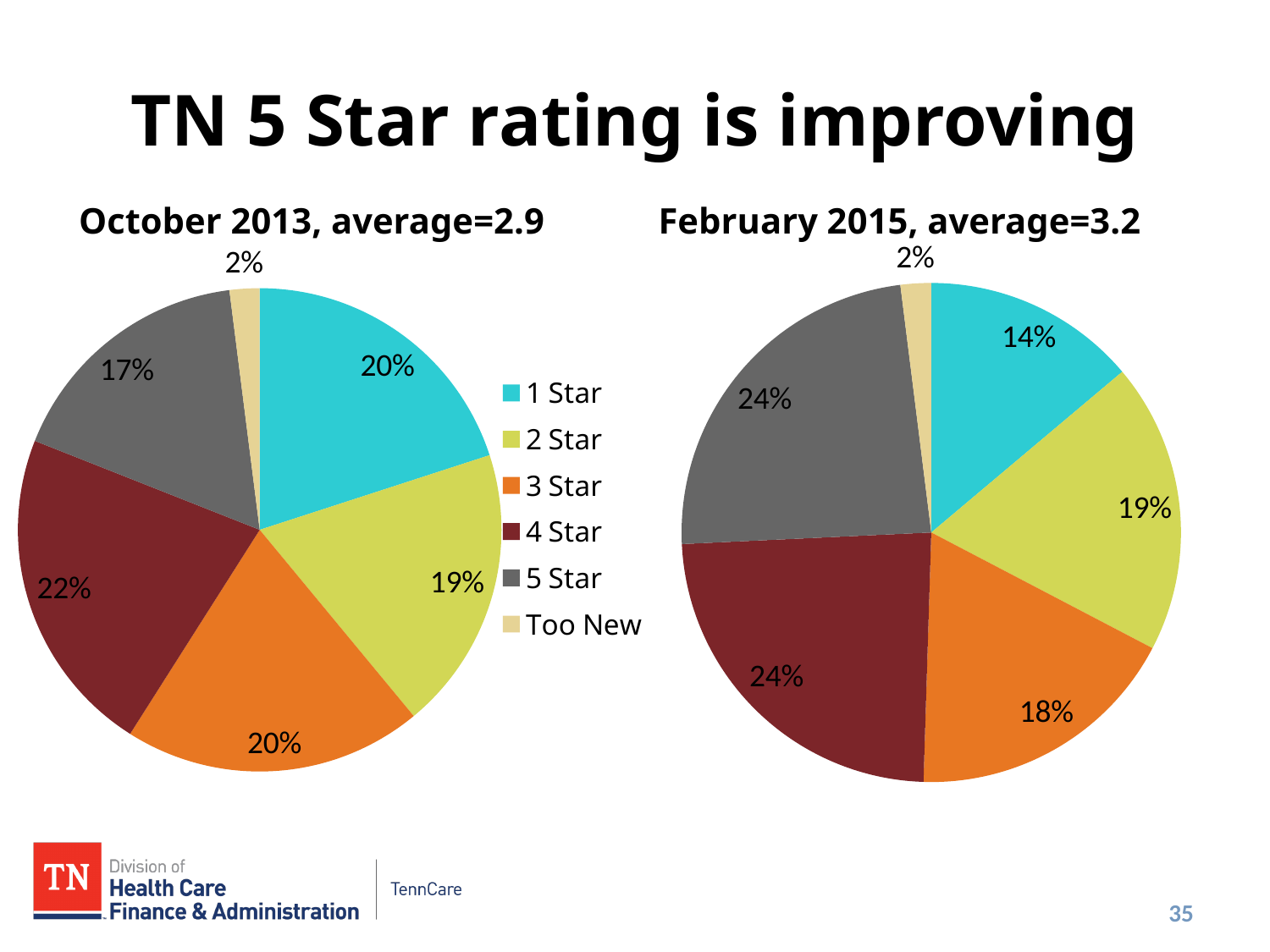
What kind of chart is used on this slide? Pie chart In the October 2013 pie chart, which category has the largest share? 4 Star In the October 2013 pie chart, what share is 4 Star? 22% What colour represents 3 Star in the legend? Orange What is the average rating shown in the title of the February 2015 chart? 3.2 In the February 2015 pie chart, what share is 3 Star? 18% In the October 2013 pie chart, what share is 5 Star? 17% In the February 2015 pie chart, what share is 1 Star? 14% What is the difference between the 5 Star share in February 2015 and the 5 Star share in October 2013? 7% How many categories does the legend list? 6 In the February 2015 pie chart, which is larger, the 2 Star share or the 1 Star share? 2 Star In the February 2015 pie chart, which category has the smallest share? Too New